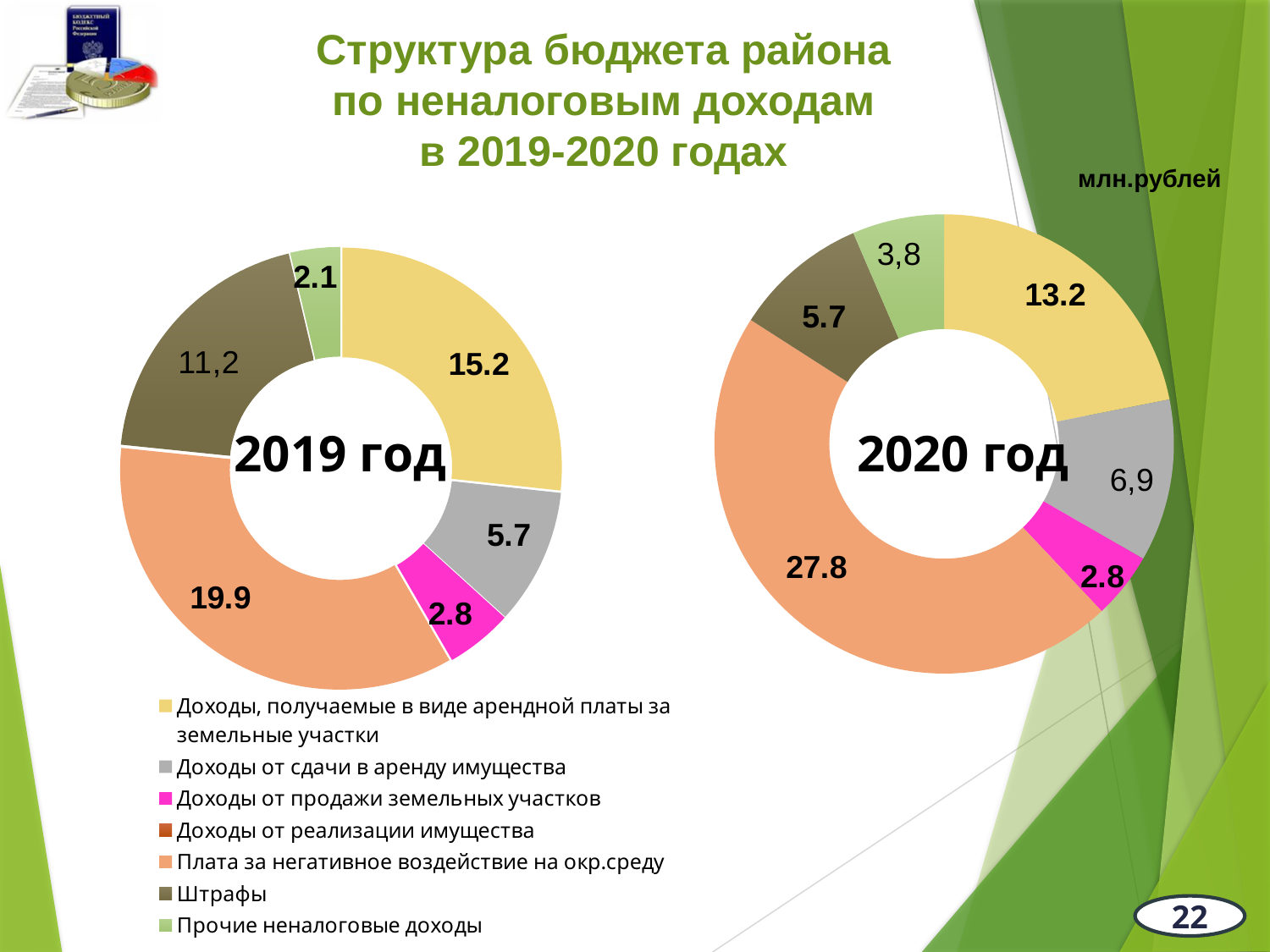
What kind of chart is the 2020 год chart? Doughnut (pie) chart How many entries does the legend list? 7 In the 2020 год chart, what is the value for Доходы, получаемые в виде арендной платы за земельные участки? 13.2 In the 2020 год chart, what is the value for Прочие неналоговые доходы? 3,8 Which is larger in the 2020 год chart: Доходы от сдачи в аренду имущества or Штрафы? Доходы от сдачи в аренду имущества In the 2019 год chart, which category has the largest value? Плата за негативное воздействие на окр.среду In the 2019 год chart, what is the value for Плата за негативное воздействие на окр.среду? 19.9 In the 2019 год chart, which category has the smallest labelled value? Прочие неналоговые доходы What is the difference between the value for Штрафы in the 2019 год chart and in the 2020 год chart? 5.5 In the 2020 год chart, what is the value for Доходы от сдачи в аренду имущества? 6,9 What is the difference between the value for Плата за негативное воздействие на окр.среду in the 2020 год chart and in the 2019 год chart? 7.9 In the 2019 год chart, what is the value for Штрафы? 11,2